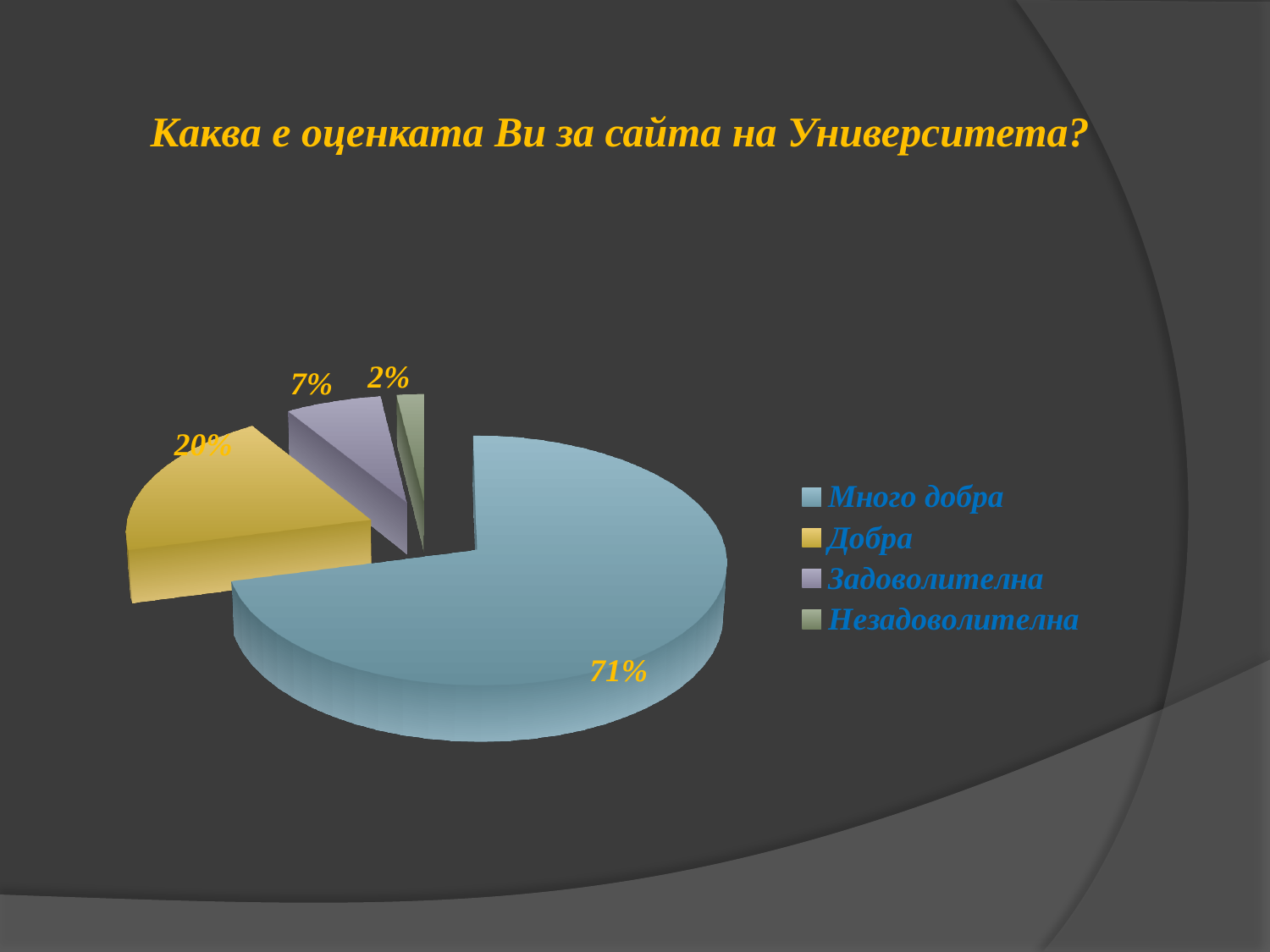
What share of the pie does "Незадоволителна" have? 2% What colour is the slice for "Добра"? yellow What share of the pie does "Добра" have? 20% What kind of chart is shown on the slide? pie chart How many categories does the pie chart have? 4 Which is larger, the slice for "Добра" or the slice for "Задоволителна"? Добра What is the difference in percentage points between "Много добра" and "Добра"? 51 What share of the pie does "Много добра" have? 71% Which category has the largest slice of the pie? Много добра What is the title of the chart? Каква е оценката Ви за сайта на Университета? Which category has the smallest slice of the pie? Незадоволителна